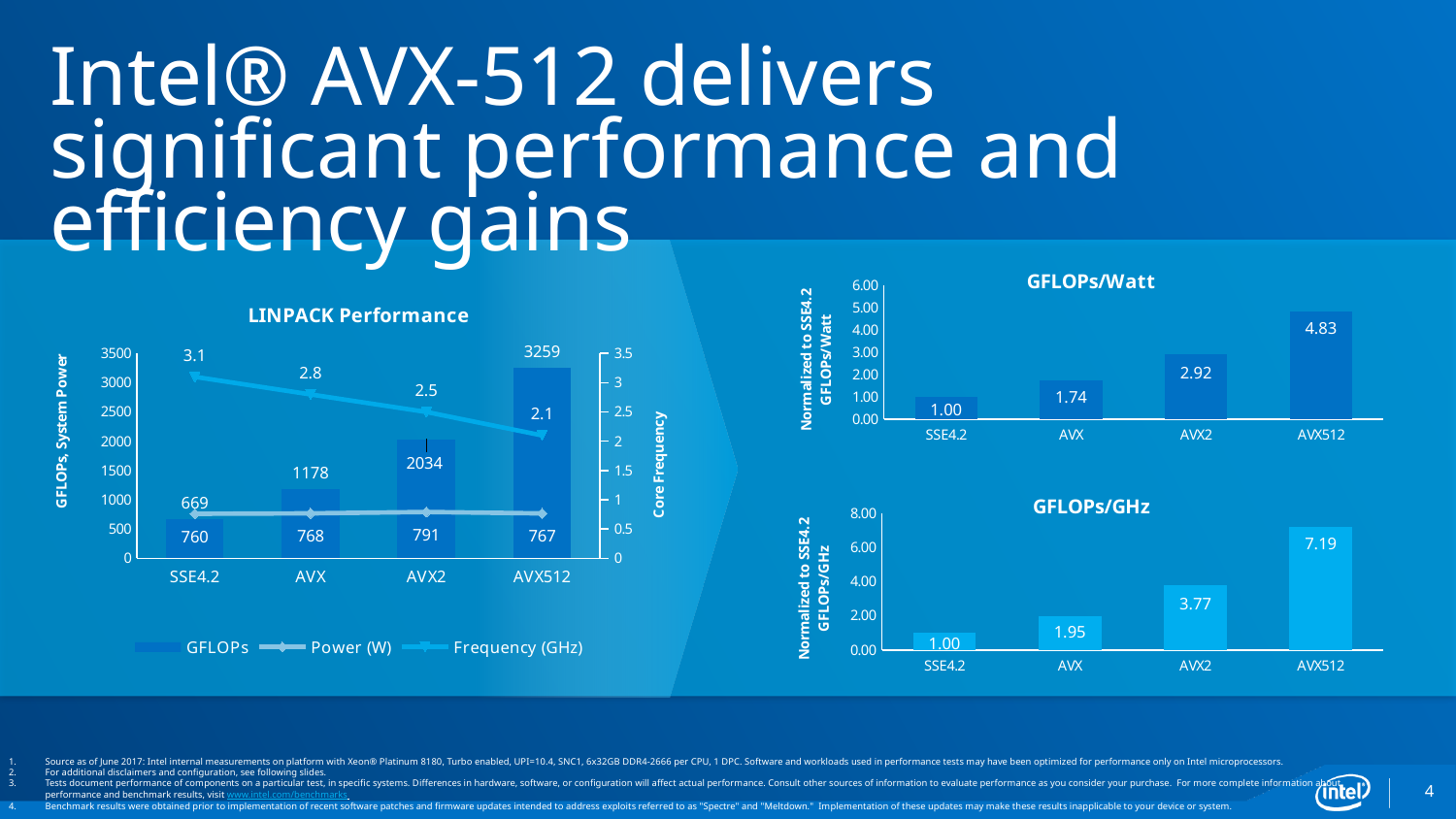
How many series does the legend of the LINPACK Performance chart list? 3 In the GFLOPs/GHz chart, what is the value for AVX512? 7.19 In the LINPACK Performance chart, what is the Frequency (GHz) value for SSE4.2? 3.1 In the LINPACK Performance chart, which category has the highest GFLOPs value? AVX512 In the LINPACK Performance chart, what is the difference in GFLOPs between AVX512 and SSE4.2? 2590 In the GFLOPs/Watt chart, what is the value for AVX2? 2.92 In the GFLOPs/Watt chart, which category has the lowest value? SSE4.2 In the GFLOPs/GHz chart, which is larger, the value for AVX or the value for AVX2? AVX2 In the LINPACK Performance chart, does the Frequency (GHz) line rise or fall from SSE4.2 to AVX512? fall In the LINPACK Performance chart, what is the GFLOPs value for AVX2? 2034 What kind of chart is the GFLOPs/GHz chart? bar chart In the LINPACK Performance chart, what is the Power (W) value for AVX512? 767